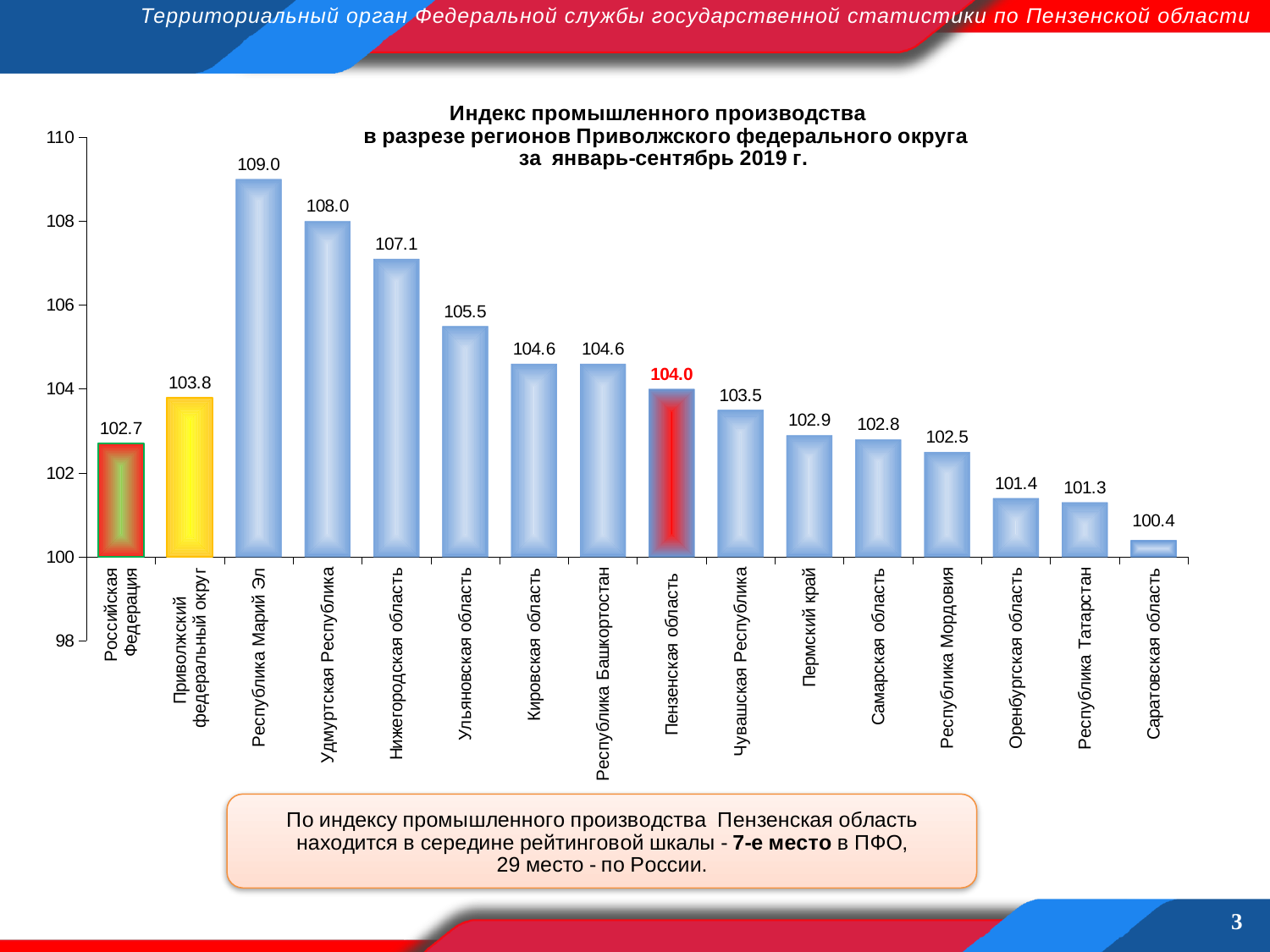
What is the value for Пензенская область? 104.0 Which category has the lowest value? Саратовская область What is the difference between the values for Республика Марий Эл and Саратовская область? 8.6 What is the value for Российская Федерация? 102.7 Which is larger, the value for Удмуртская Республика or the value for Нижегородская область? Удмуртская Республика What colour is the bar for Пензенская область? Red How many categories (bars) are shown in the chart? 16 What is the value for Приволжский федеральный округ? 103.8 Which category has the highest value? Республика Марий Эл What kind of chart is shown on the slide? Bar chart What is the difference between the values for Пензенская область and Российская Федерация? 1.3 What is the value for Республика Татарстан? 101.3